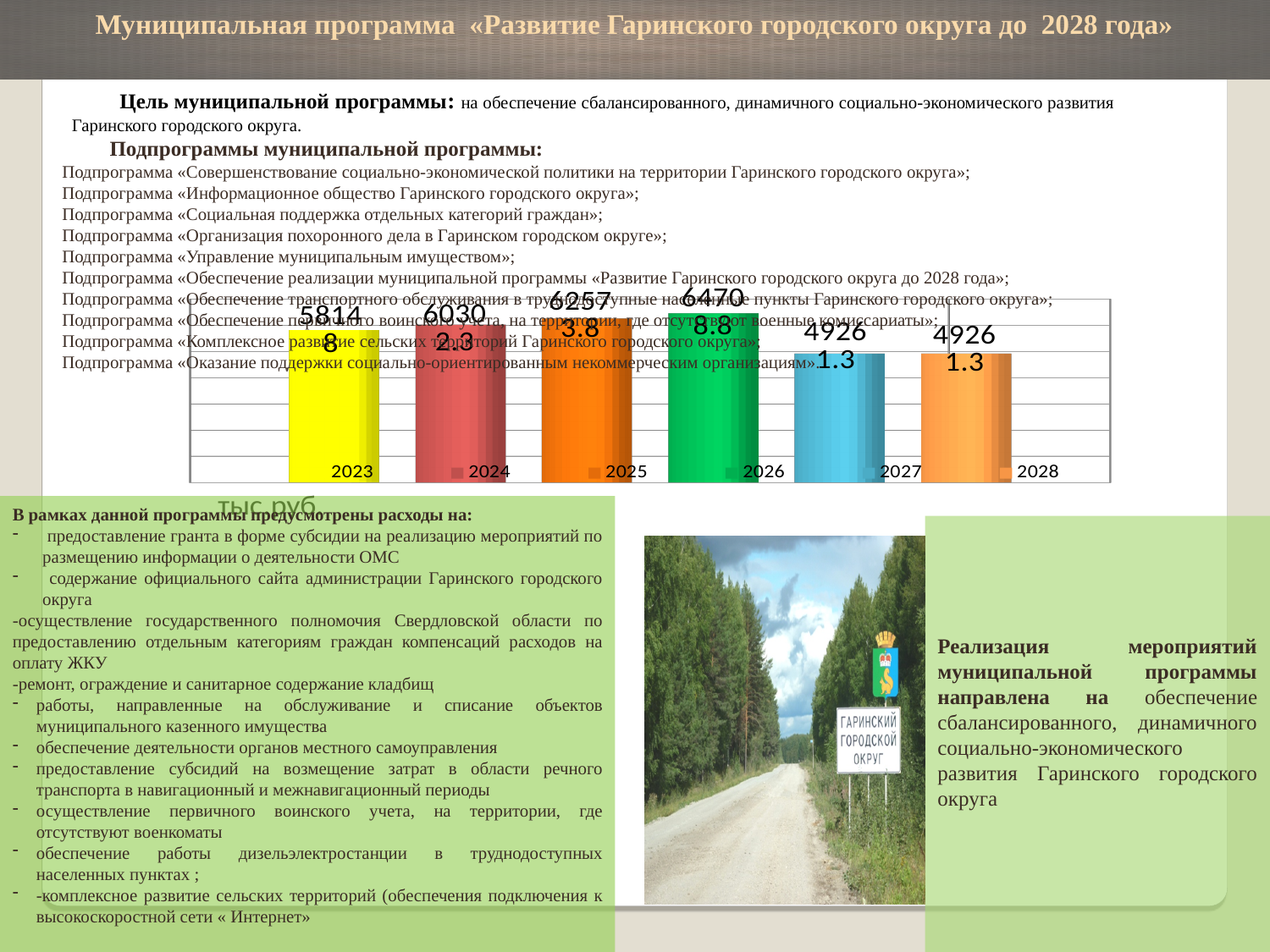
What kind of chart is shown on the slide? bar chart What is the value shown for 2023 in the bar chart? 58148 What is the difference between the values for 2025 and 2024 in the bar chart? 2271.5 What is the value shown for 2026 in the bar chart? 64708.8 What is the value shown for 2027 in the bar chart? 49261.3 What is the value shown for 2024 in the bar chart? 60302.3 What unit label is written below the bar chart? тыс.руб What is the value shown for 2025 in the bar chart? 62573.8 Which year has the larger value in the bar chart, 2024 or 2025? 2025 What is the difference between the values for 2026 and 2023 in the bar chart? 6560.8 Which year has the highest value in the bar chart? 2026 How many years are shown on the x axis of the bar chart? 6